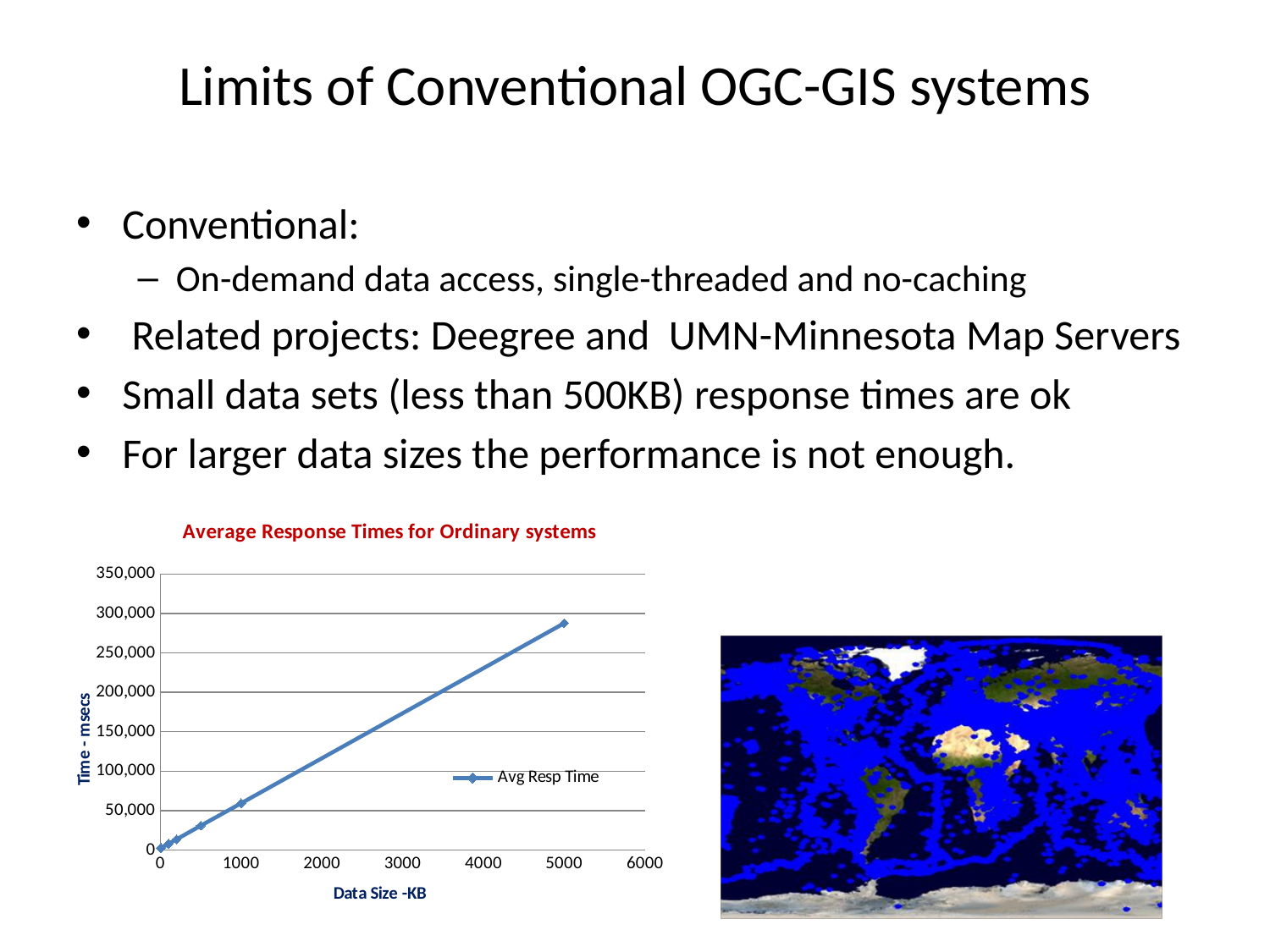
Does the average response time rise or fall as data size increases along the x axis? rise Which data size has the highest average response time, 1000 KB or 5000 KB? 5000 KB What is the name of the series shown in the chart's legend? Avg Resp Time Is the value for Avg Resp Time at a data size of 5000 KB greater or less than 250,000? greater Is the value for Avg Resp Time at a data size of 5000 KB greater or less than 300,000? less What is the label of the chart's x axis? Data Size -KB What kind of chart is shown on the slide? line chart What is the title of the chart on the slide? Average Response Times for Ordinary systems Is the value for Avg Resp Time at a data size of 1000 KB greater or less than 100,000? less How many series does the chart's legend list? 1